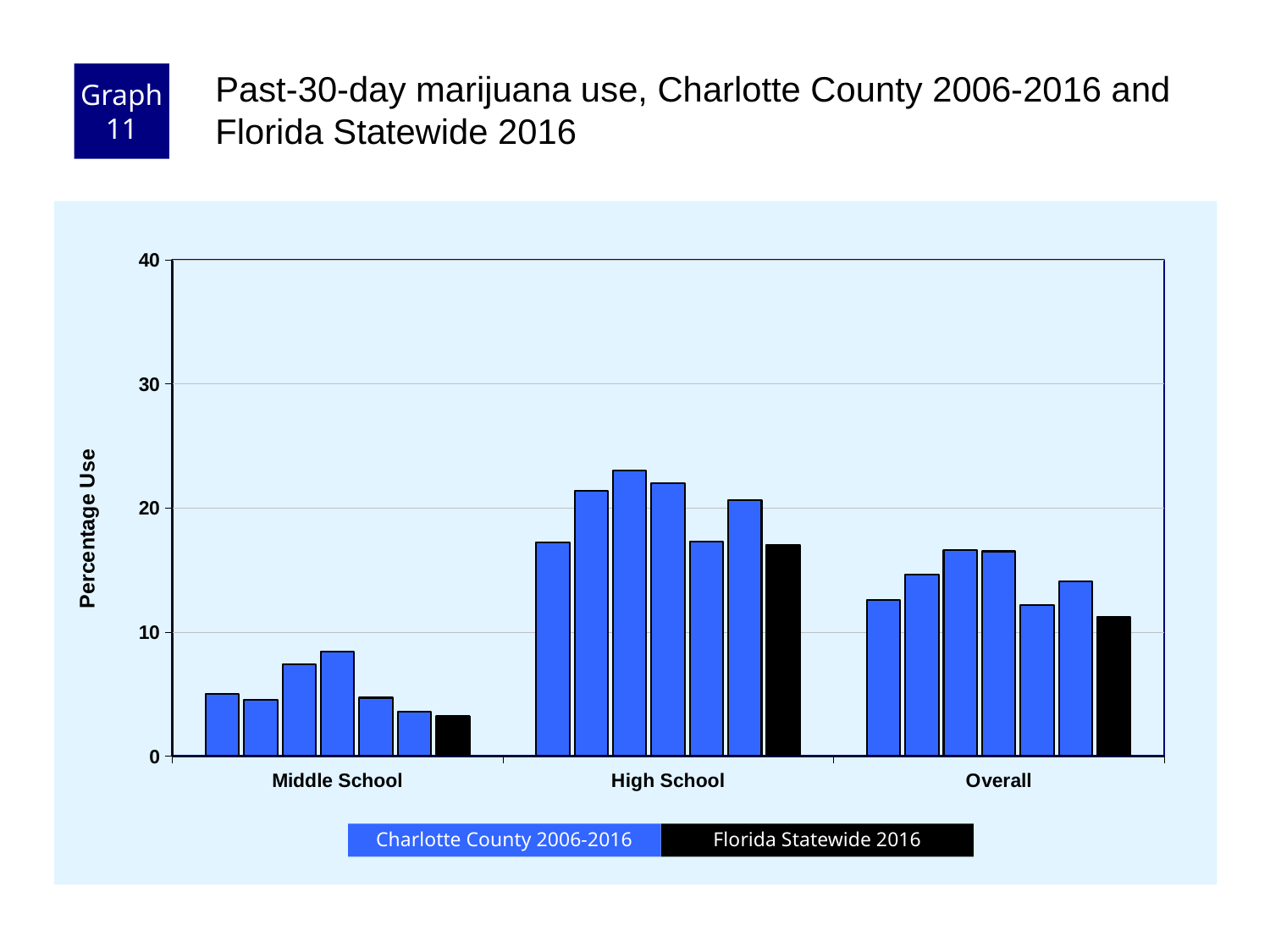
Is the Florida Statewide 2016 value for High School greater or less than 20? less What kind of chart is shown on the slide? bar chart How many series does the legend list? 2 Which is larger: the Florida Statewide 2016 bar for High School or the Florida Statewide 2016 bar for Overall? High School How many categories are shown along the x axis? 3 Which category has the tallest bars overall? High School Is the Florida Statewide 2016 value for High School greater or less than 10? greater Is the highest Charlotte County bar for High School greater or less than 20? greater What is the label on the y axis? Percentage Use Which category has the shortest bars overall? Middle School Which colour represents Florida Statewide 2016 in the legend? black